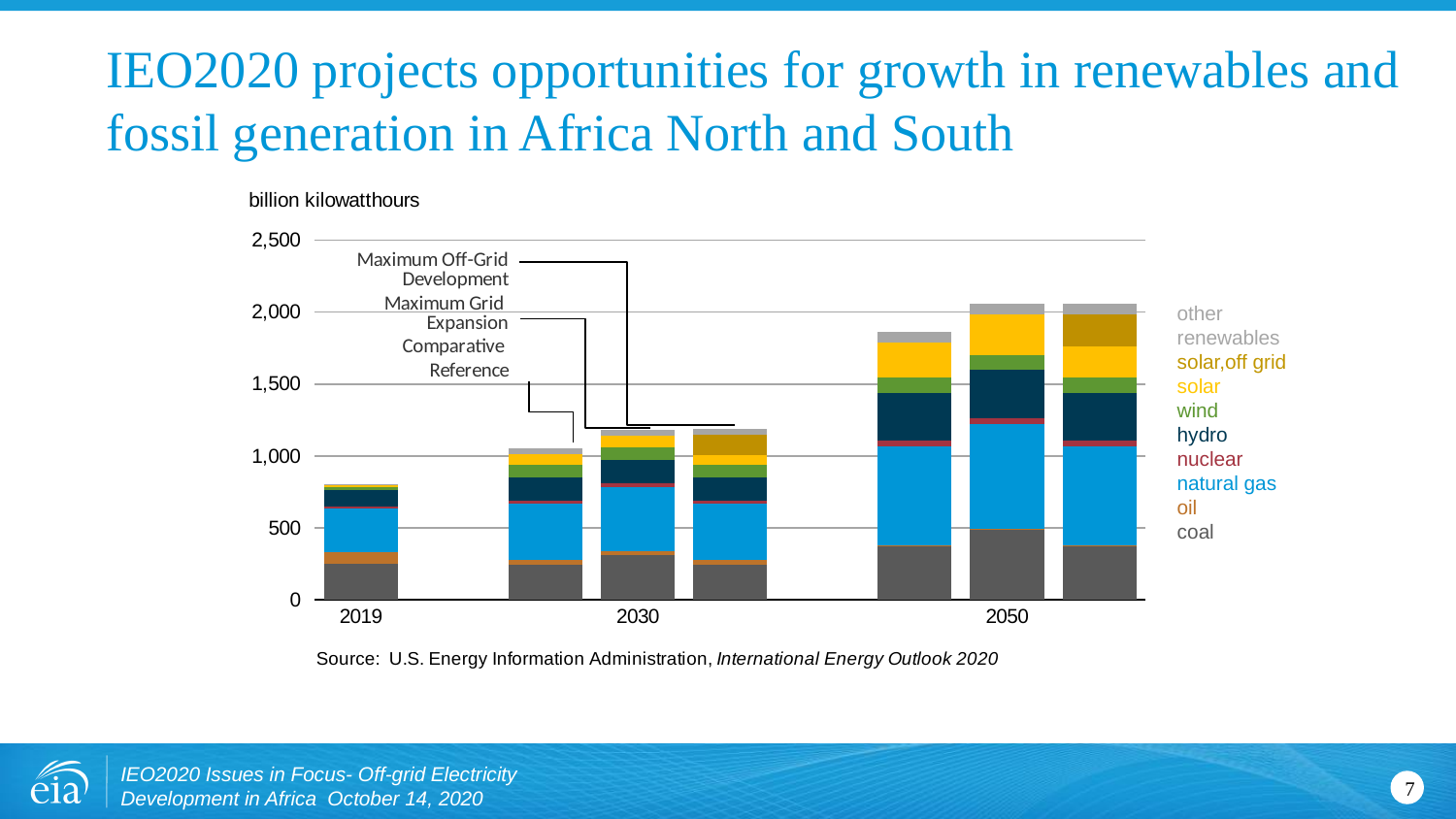
What kind of chart is shown on the slide? stacked bar chart Which is larger, the total for the 2050 Comparative Reference bar or the 2019 bar? 2050 Comparative Reference Is the total generation for 2019 greater or less than 1,000 billion kilowatthours? less Do the total generation values rise or fall from 2019 to 2050? rise Which year has the lowest total generation? 2019 Is the total for the 2030 Maximum Off-Grid Development bar greater or less than 1,000 billion kilowatthours? greater How many years are labelled on the x axis of the chart? 3 How many series does the chart's legend list? 9 Is the coal segment of the 2019 bar greater or less than 500 billion kilowatthours? less What unit is the chart's y axis measured in? billion kilowatthours Which series is shown at the bottom of each stacked bar? coal